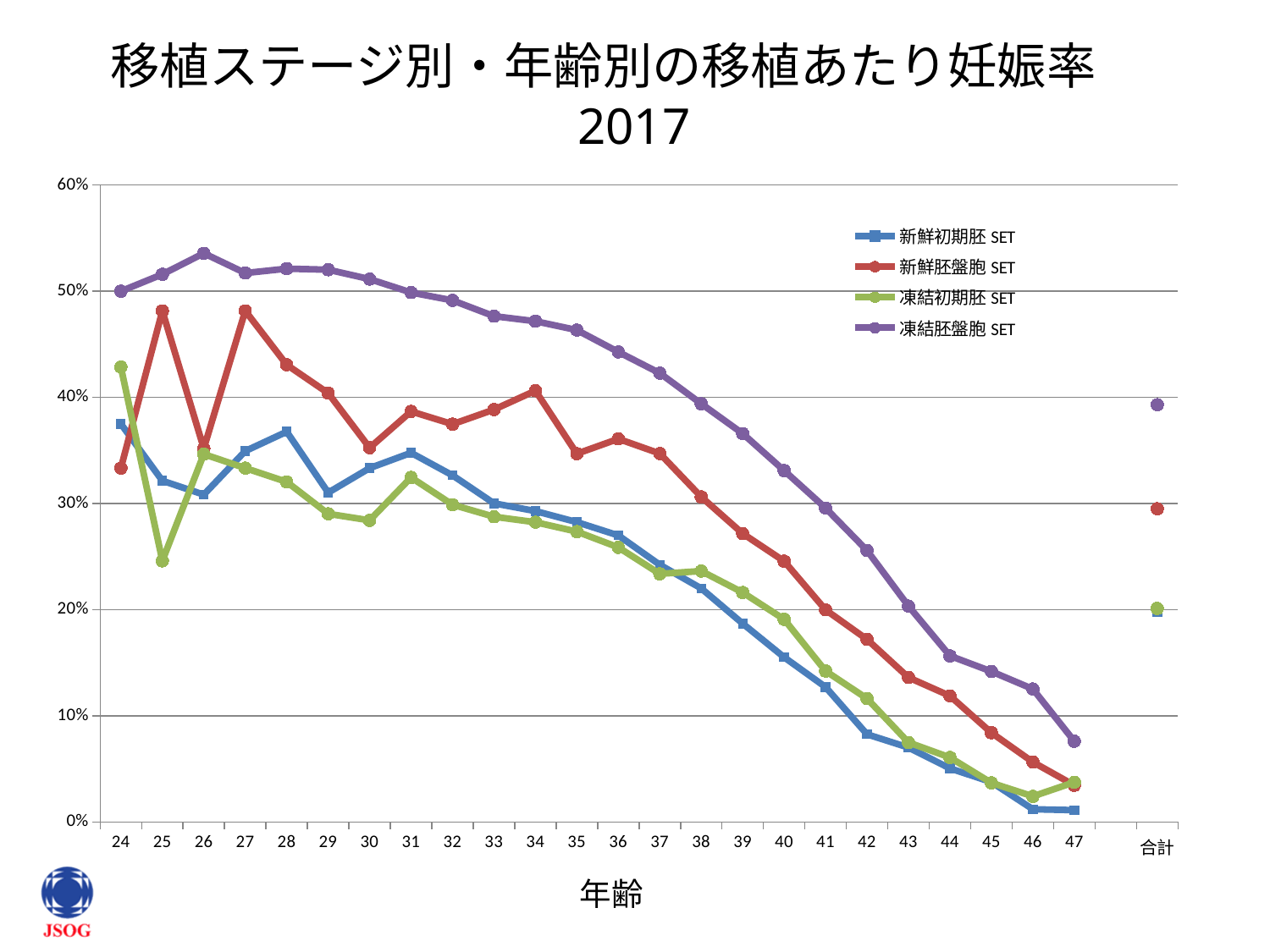
Is the value for 新鮮胚盤胞 SET at age 25 greater or less than 40%? greater What is the label of the x axis? 年齢 Is the value for 新鮮初期胚 SET at age 46 greater or less than 10%? less At age 40, which is larger: 凍結胚盤胞 SET or 新鮮初期胚 SET? 凍結胚盤胞 SET How many individual age values are shown on the x axis (excluding 合計)? 24 What kind of chart is shown on the slide? line chart How many series does the legend list? 4 Which series has the highest value in the 合計 column? 凍結胚盤胞 SET Is the value for 凍結胚盤胞 SET at age 26 greater or less than 50%? greater Does the 凍結胚盤胞 SET line rise or fall from age 30 to age 47? fall At age 24, which is larger: 凍結初期胚 SET or 新鮮胚盤胞 SET? 凍結初期胚 SET